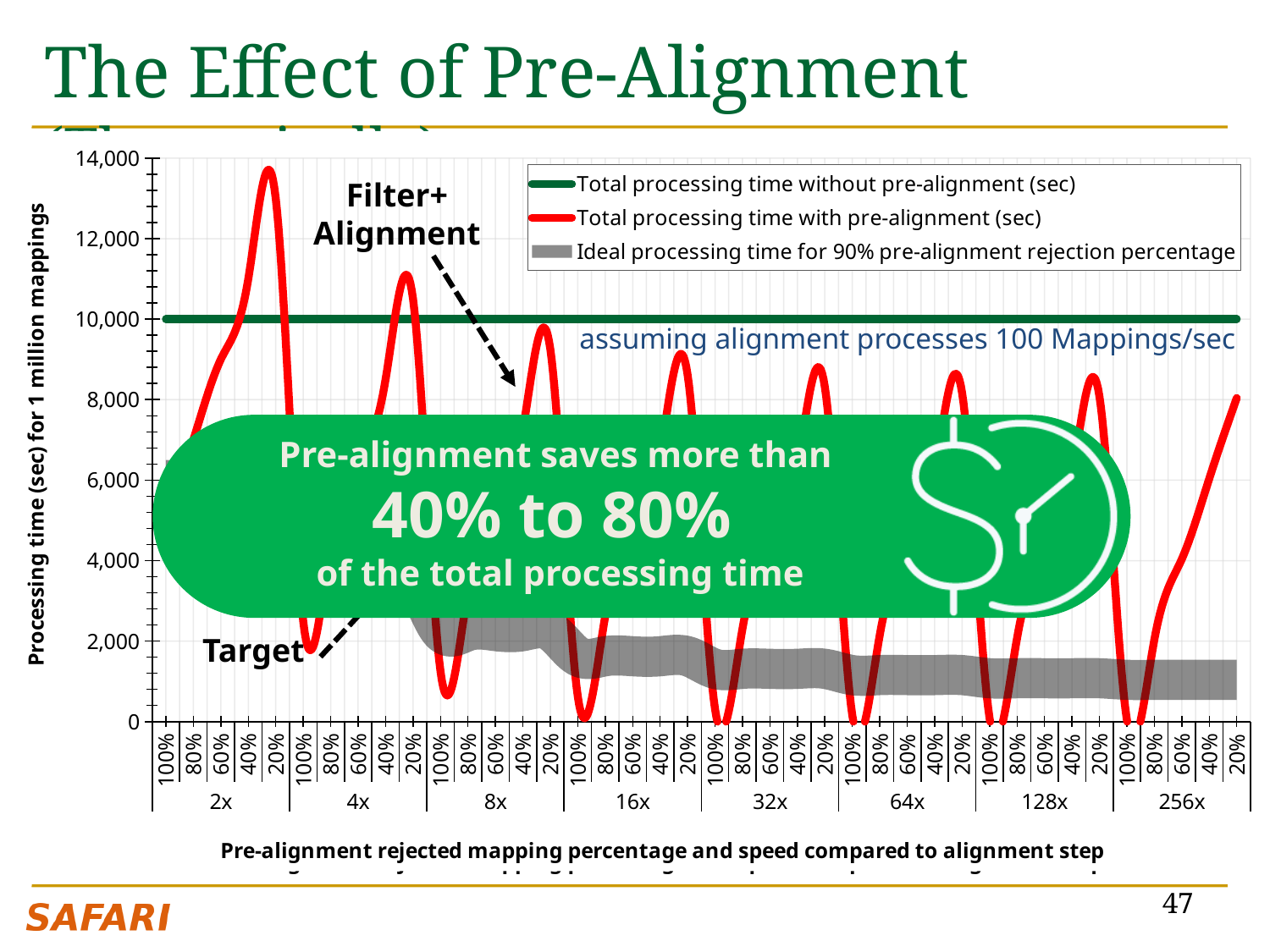
Is the total processing time with pre-alignment at 256x speed and 20% rejection greater or less than 10,000? less Do the peaks of the red line (total processing time with pre-alignment) rise or fall as the speed increases from 2x to 256x? fall Is the total processing time with pre-alignment at 4x speed and 20% rejection greater or less than 10,000? greater How many rejected mapping percentage labels are shown within each speed group on the x axis? 5 Which is larger at 2x speed and 20% rejection: the total processing time with pre-alignment or without pre-alignment? with pre-alignment What is the label of the vertical axis of the chart? Processing time (sec) for 1 million mappings What is the total processing time without pre-alignment (sec) shown by the green line? 10,000 How many series does the chart legend list? 3 Is the total processing time with pre-alignment at 2x speed and 20% rejection greater or less than 12,000? greater How many pre-alignment speed groups (2x, 4x, ...) are shown on the x axis? 8 Does the green line for total processing time without pre-alignment rise, fall, or stay flat along the x axis? stays flat What kind of chart is shown on the slide? line chart